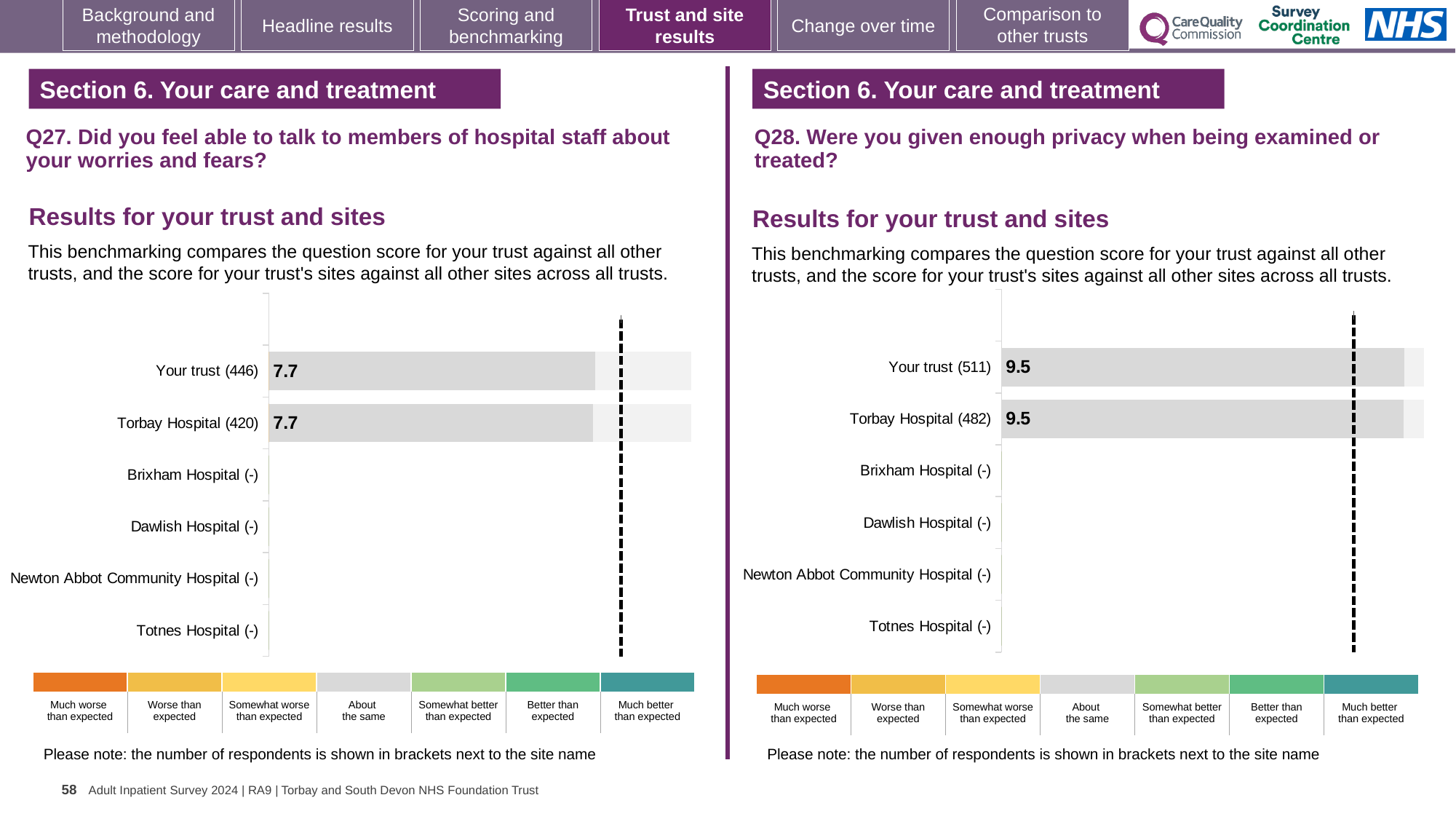
How many site/trust categories are listed on the y axis of the Q28 chart on the right? 6 In the Q28 chart on the right, how many respondents are shown in brackets for Your trust? 511 In the Q28 chart on the right, what is the score for Your trust? 9.5 In the Q27 chart on the left, which category falls in the 'Much better than expected' band of the colour scale? None What kind of chart is used for the Q27 results on the left? Bar chart In the Q28 chart on the right, how many categories have no score shown (marked with '-')? 4 In the Q28 chart on the right, what is the score for Torbay Hospital? 9.5 In the Q27 chart on the left, what is the difference between the scores for Your trust and Torbay Hospital? 0 In the Q27 chart on the left, what is the score for Your trust? 7.7 In the Q27 chart on the left, what is the score for Torbay Hospital? 7.7 How many bands does the colour scale below the Q27 chart on the left contain? 7 In the Q27 chart on the left, how many respondents are shown in brackets for Torbay Hospital? 420